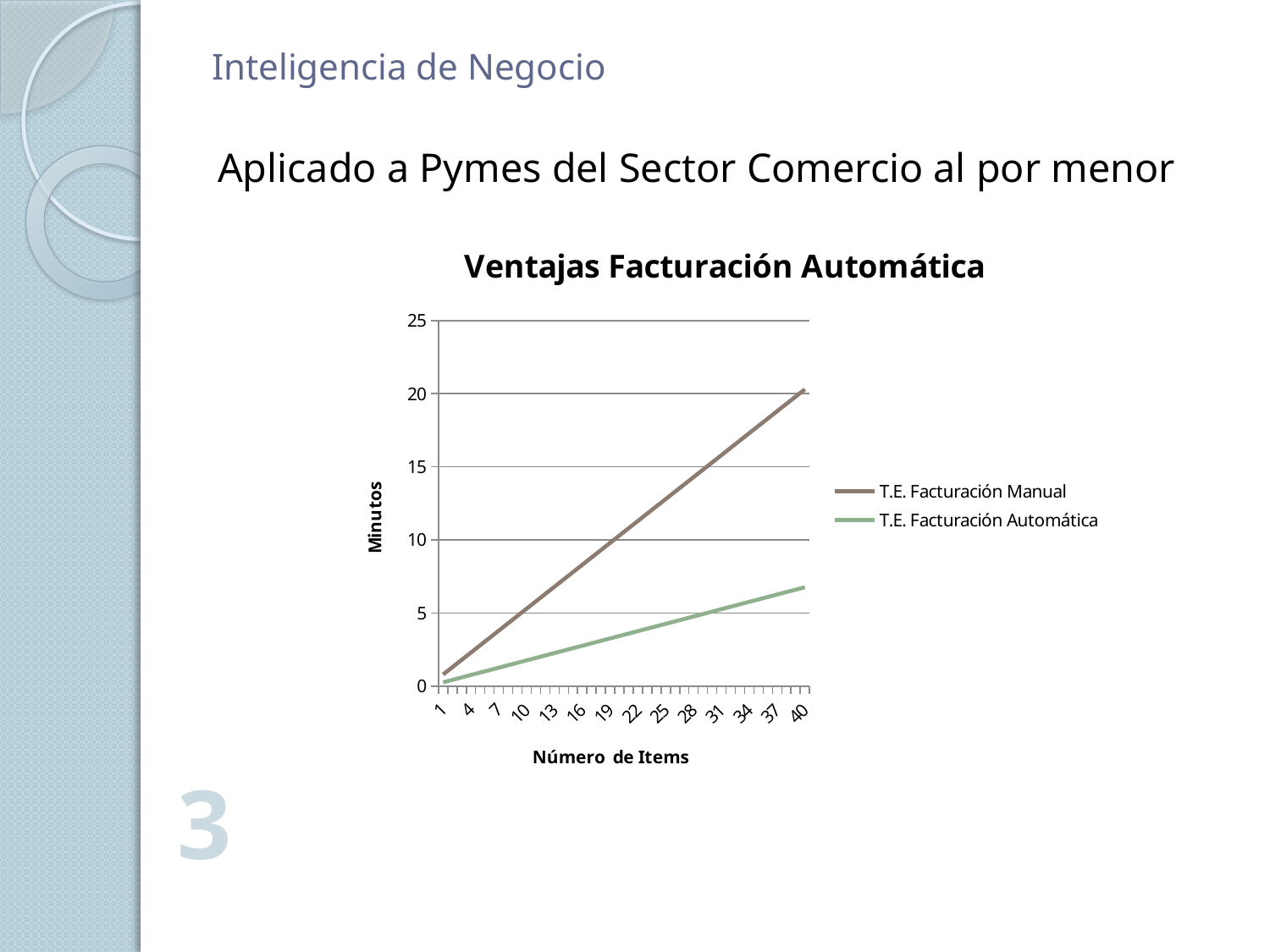
What is the title of the chart? Ventajas Facturación Automática Which series has the higher value at 40 items? T.E. Facturación Manual Do the values for T.E. Facturación Automática rise or fall along the x axis? rise How many labelled tick values are shown on the x axis? 14 Do the values for T.E. Facturación Manual rise or fall as the number of items increases? rise Is the value for T.E. Facturación Automática at 40 items greater or less than 10? less What is the label of the vertical axis? Minutos Which series has the lowest value at 40 items? T.E. Facturación Automática What kind of chart is shown on the slide? line chart Is the value for T.E. Facturación Manual at 40 items greater or less than 15? greater How many series does the legend list? 2 Is the value for T.E. Facturación Automática at 40 items greater or less than 5? greater